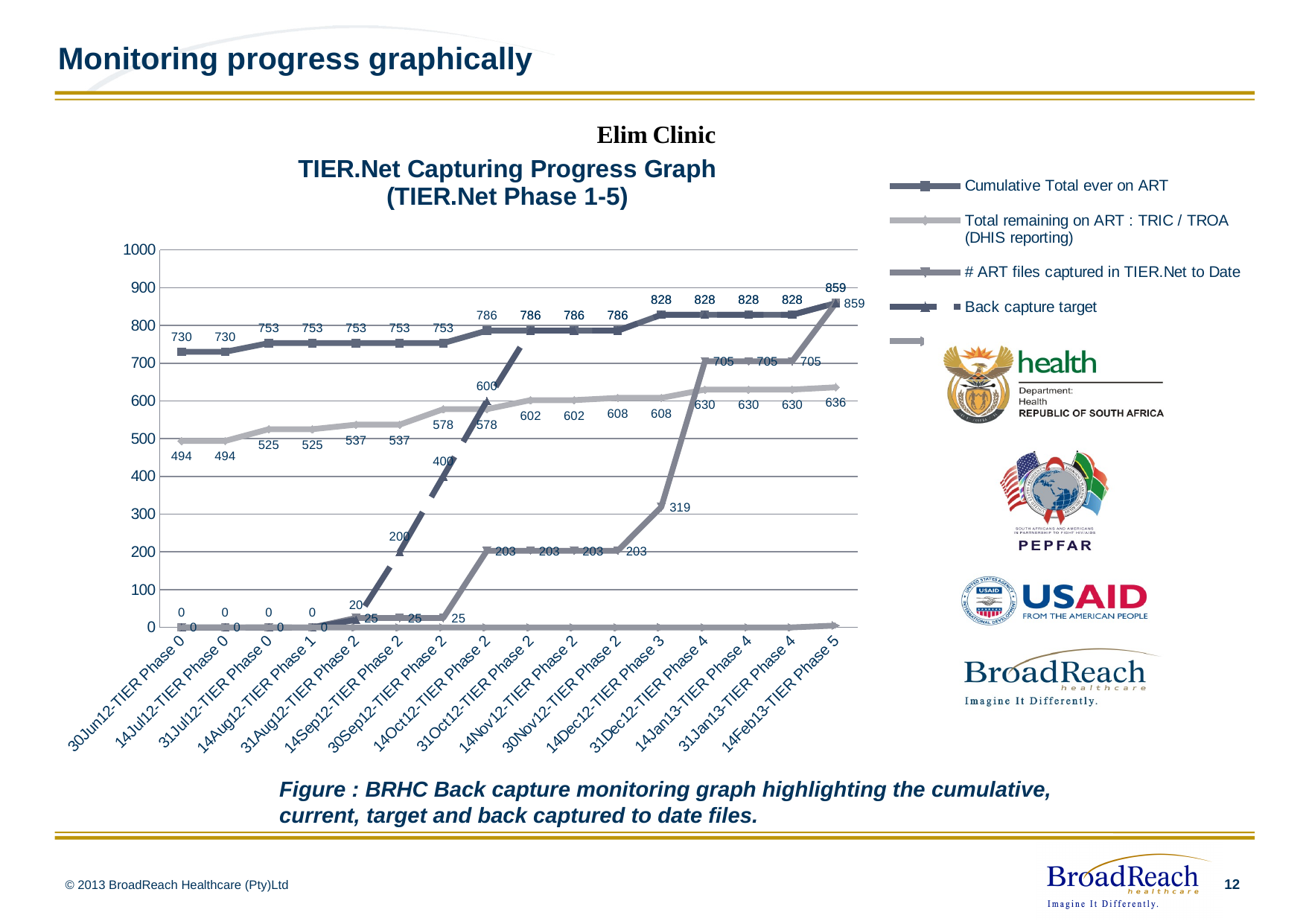
What is the Back capture target value at 14Oct12-TIER Phase 2? 600 At 14Jan13-TIER Phase 4, which is larger: the # ART files captured in TIER.Net to Date or the Total remaining on ART? # ART files captured in TIER.Net to Date What is the Total remaining on ART (TRIC / TROA) at 30Jun12-TIER Phase 0? 494 What is the Cumulative Total ever on ART at 30Jun12-TIER Phase 0? 730 Does the Cumulative Total ever on ART rise or fall across the x axis? Rises At which date does the Total remaining on ART series reach its highest value? 14Feb13-TIER Phase 5 What is the Cumulative Total ever on ART at 14Feb13-TIER Phase 5? 859 What is the difference between the Cumulative Total ever on ART and the Total remaining on ART at 14Feb13-TIER Phase 5? 223 What kind of chart is shown on the slide? Line chart How many dates (categories) are shown on the x axis? 16